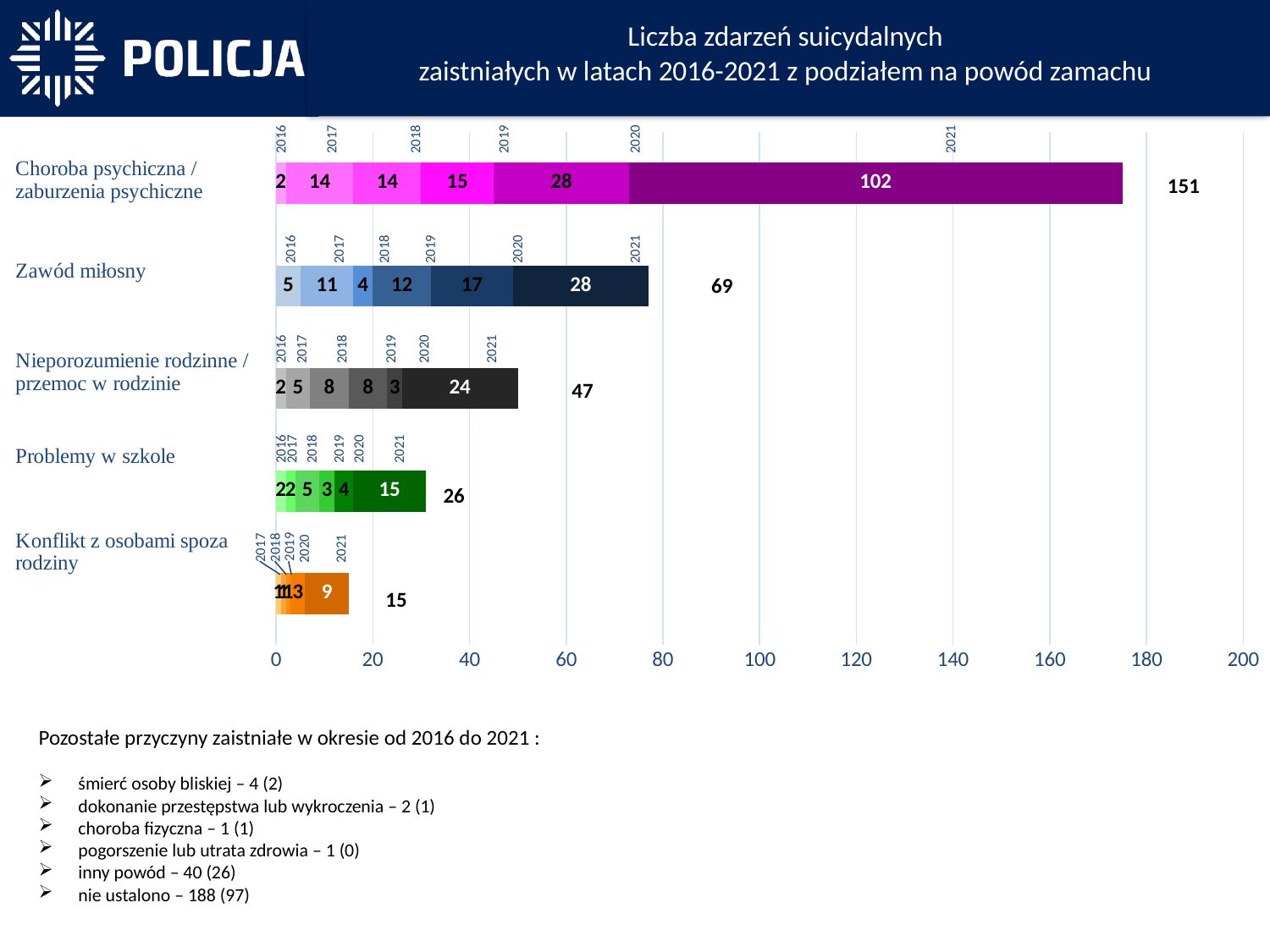
What is the 2021 value for 'Problemy w szkole'? 15 What is the difference between the 2021 and 2020 values for 'Zawód miłosny'? 11 Which is larger: the 2021 value for 'Choroba psychiczna / zaburzenia psychiczne' or the 2021 value for 'Zawód miłosny'? Choroba psychiczna / zaburzenia psychiczne Which category has the longest bar on the chart? Choroba psychiczna / zaburzenia psychiczne Which category has the shortest bar on the chart? Konflikt z osobami spoza rodziny What is the 2021 value for 'Choroba psychiczna / zaburzenia psychiczne'? 102 What is the 2021 value for 'Nieporozumienie rodzinne / przemoc w rodzinie'? 24 What is the 2021 value for 'Konflikt z osobami spoza rodziny'? 9 How many reason categories are plotted on the chart? 5 Is the total length of the bar for 'Zawód miłosny' greater or less than 100? less What is the 2020 value for 'Zawód miłosny'? 17 What kind of chart is shown on the slide? Stacked bar chart